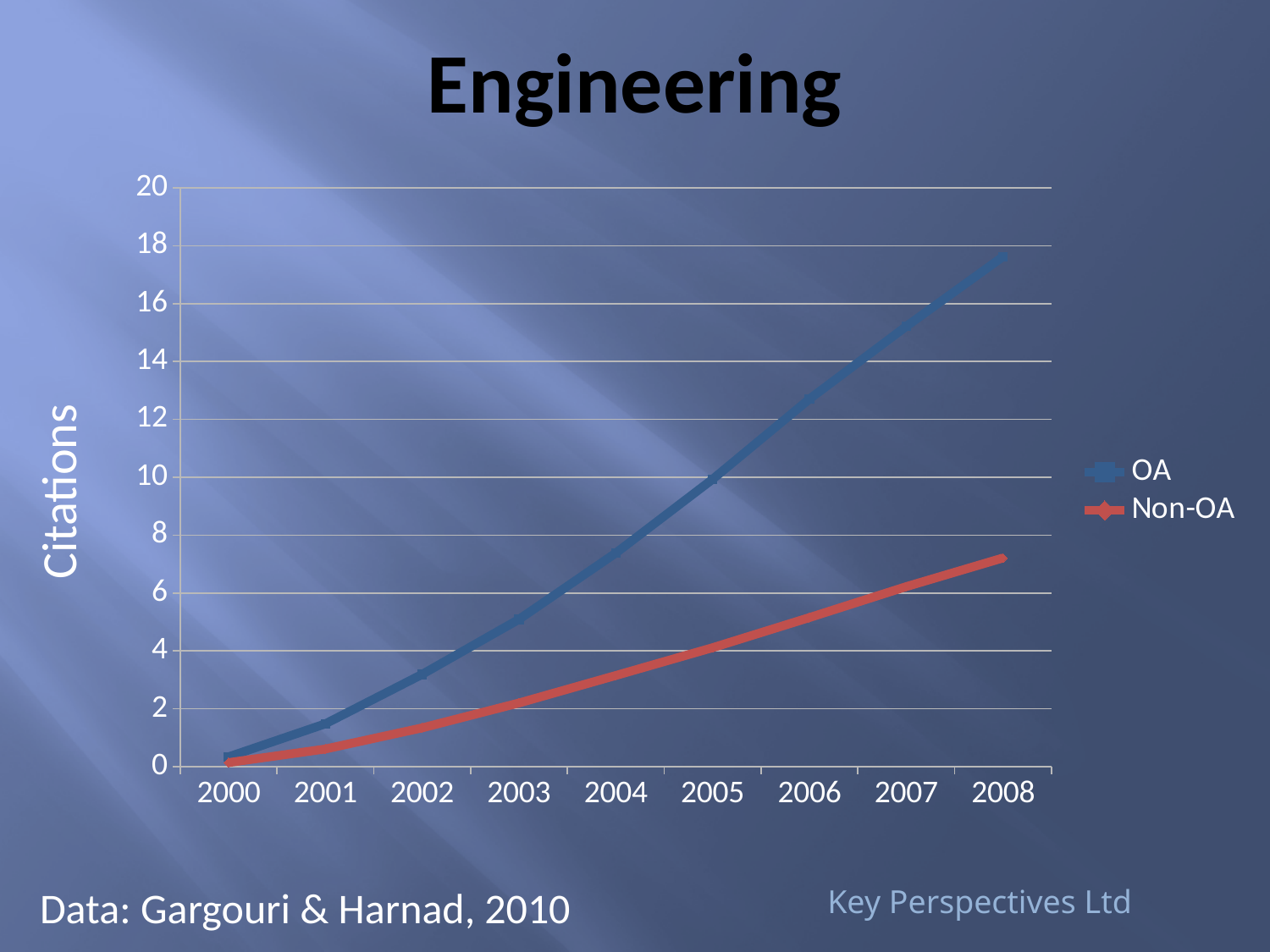
How many years are plotted along the x axis? 9 Is the value for Non-OA in 2008 greater or less than 6? greater What kind of chart is shown on the slide? line chart Is the value for OA in 2008 greater or less than 16? greater Is the value for OA in 2006 greater or less than 14? less How many series does the legend list? 2 In which year is the Non-OA series at its lowest? 2000 What is the label on the y axis? Citations Do the OA citations rise or fall from 2000 to 2008? rise Which series has the higher value in 2008, OA or Non-OA? OA In which year is the OA series at its highest? 2008